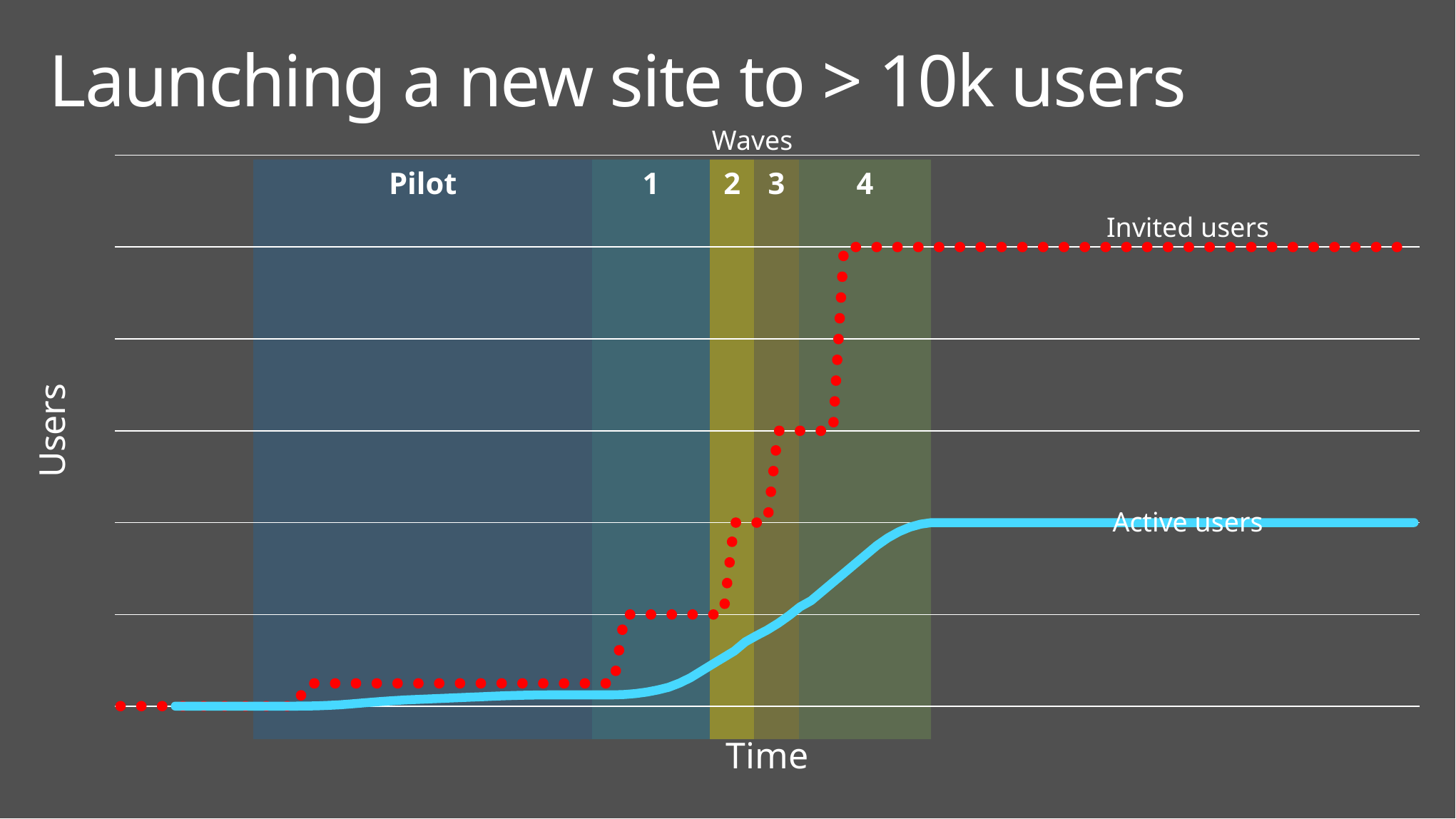
At the right end of the chart, which series is higher: Invited users or Active users? Invited users What is the label of the x axis? Time How many numbered waves are marked on the chart? 4 Do the Active users values rise or fall along the x axis? rise What is the label of the y axis? Users What is the label of the shaded phase that comes before wave 1? Pilot How many data series are plotted on the chart? 2 What kind of chart is shown on the slide? line chart Do the Invited users values rise or fall along the x axis? rise In which wave does the Invited users line make its largest single jump? 4